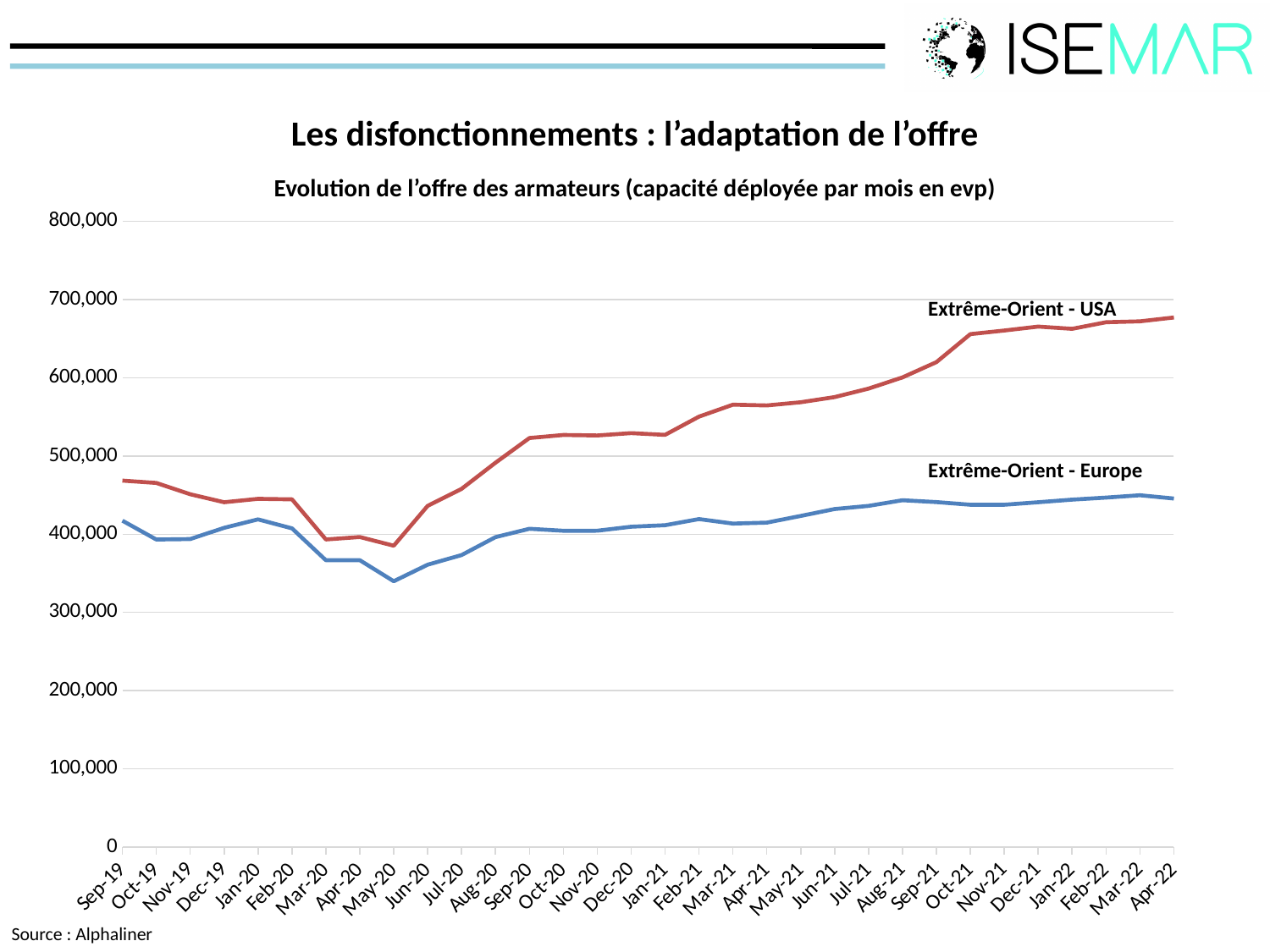
Is the value for Extrême-Orient - Europe in May-20 greater or less than 400,000? less What source is cited for the chart? Alphaliner Is the value for Extrême-Orient - USA in Apr-22 greater or less than 600,000? greater How many series are plotted on the chart? 2 Is the value for Extrême-Orient - USA in Sep-20 greater or less than 500,000? greater How many months are shown along the x axis of the chart? 32 Overall, does the Extrême-Orient - USA series rise or fall from Sep-19 to Apr-22? rise In which month does the Extrême-Orient - Europe series reach its lowest value? May-20 What kind of chart is shown on the slide? line chart In Apr-22, which series has the higher value, Extrême-Orient - USA or Extrême-Orient - Europe? Extrême-Orient - USA